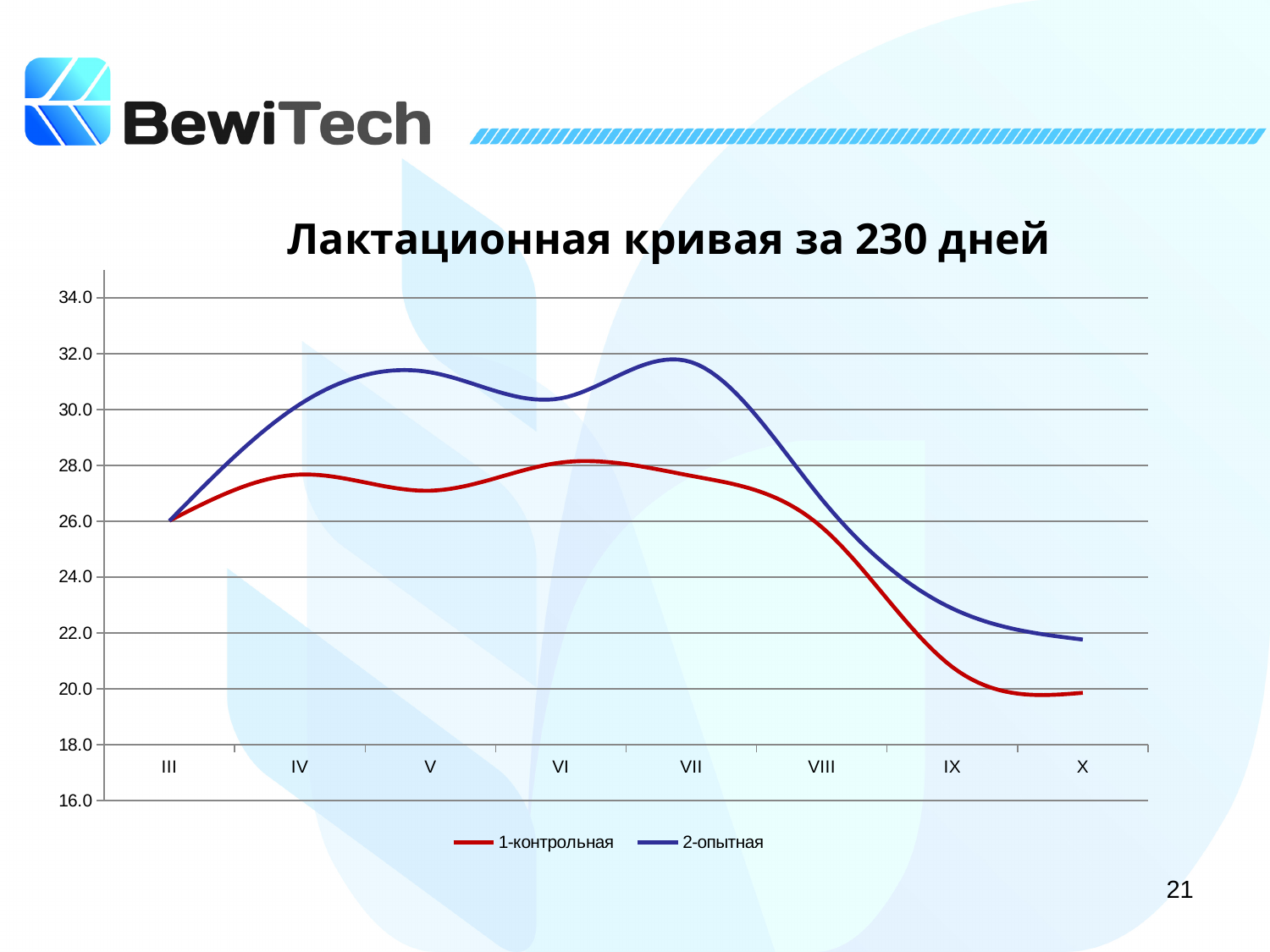
Is the value for 1-контрольная at IV greater or less than 30.0? less Is the value for 2-опытная at VII greater or less than 30.0? greater Which series is drawn in red? 1-контрольная What kind of chart is shown on the slide? line chart How many categories are shown on the x axis? 8 What is the value of both series at III? 26.0 Is the value for 2-опытная at X greater or less than 24.0? less At which x-axis category does 1-контрольная reach its lowest value? X At VII, which series has the higher value, 1-контрольная or 2-опытная? 2-опытная How many series does the legend list? 2 What is the title of the chart? Лактационная кривая за 230 дней Do the values of 1-контрольная rise or fall from VII to X? fall